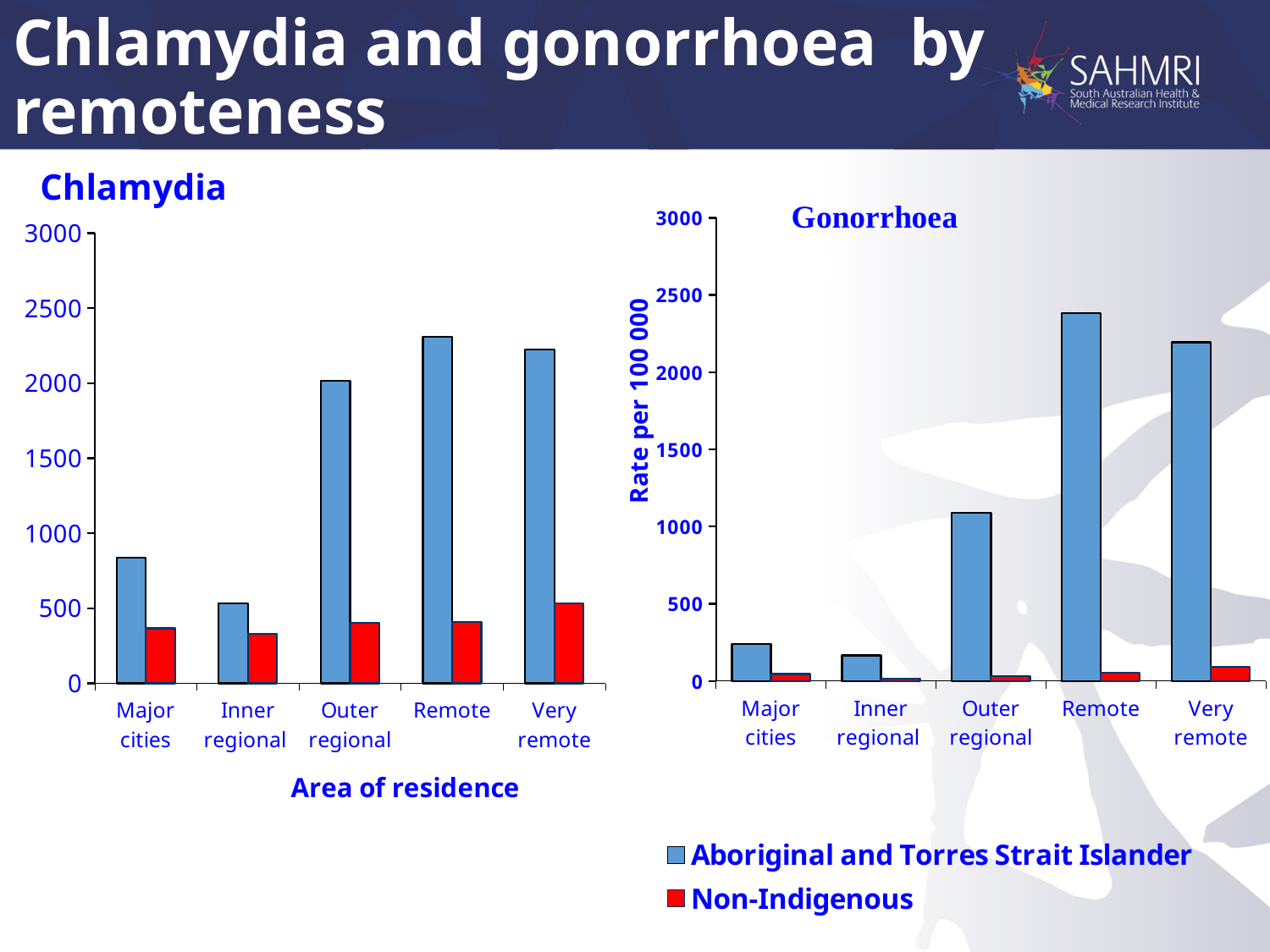
In the Chlamydia chart, is the Aboriginal and Torres Strait Islander rate for Remote greater or less than 2000? greater What kind of chart is the Chlamydia chart on the left? Bar chart In the Gonorrhoea chart, which is larger for Non-Indigenous people: the rate for Very remote or for Remote? Very remote In the Gonorrhoea chart, is the Aboriginal and Torres Strait Islander rate for Outer regional greater or less than 1000? greater In the Chlamydia chart, which area of residence has the lowest rate for Aboriginal and Torres Strait Islander people? Inner regional How many series does the legend list for the charts? 2 How many areas of residence are shown on the x axis of the Gonorrhoea chart? 5 In the Gonorrhoea chart, which area of residence has the lowest rate for Aboriginal and Torres Strait Islander people? Inner regional In the Gonorrhoea chart, which area of residence has the highest rate for Aboriginal and Torres Strait Islander people? Remote In the Chlamydia chart, is the Non-Indigenous rate for Major cities greater or less than 500? less What is the label on the vertical axis of the Gonorrhoea chart? Rate per 100 000 In the Chlamydia chart, which is larger for Aboriginal and Torres Strait Islander people: the rate for Major cities or for Inner regional? Major cities